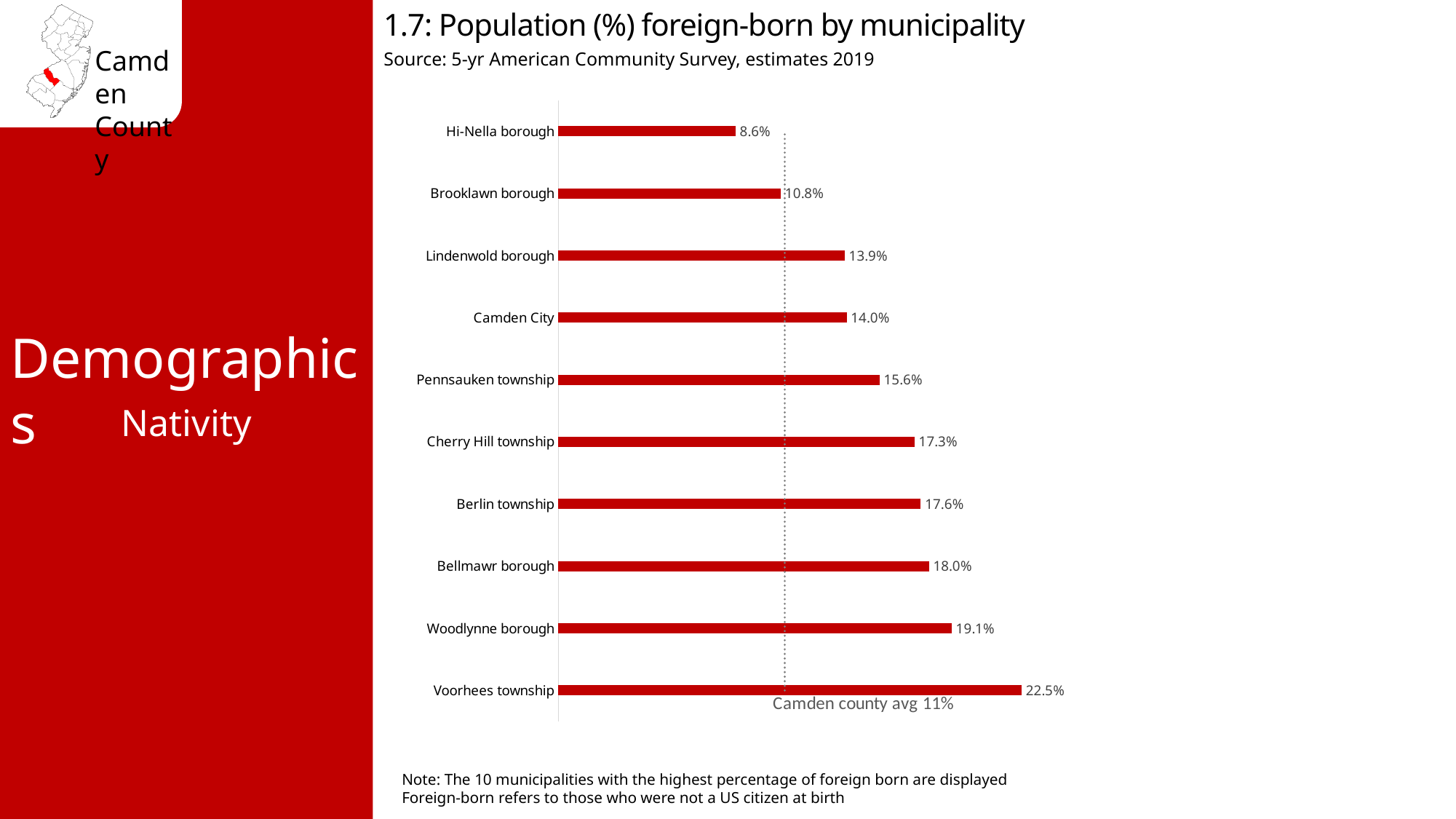
What is the foreign-born population percentage for Brooklawn borough? 10.8% What is the Camden county average foreign-born percentage marked by the dotted line? 11% Which municipality has the highest percentage of foreign-born population? Voorhees township How many municipalities are shown on the chart? 10 Which has a higher foreign-born percentage, Pennsauken township or Lindenwold borough? Pennsauken township What is the source of the data shown in the chart? 5-yr American Community Survey, estimates 2019 What is the difference in foreign-born percentage between Voorhees township and Woodlynne borough? 3.4% What is the foreign-born population percentage for Camden City? 14.0% What type of chart is used to display the foreign-born population percentages? Bar chart What is the difference in foreign-born percentage between Bellmawr borough and Berlin township? 0.4% What is the foreign-born population percentage for Cherry Hill township? 17.3% Which municipality has the lowest percentage of foreign-born population on the chart? Hi-Nella borough